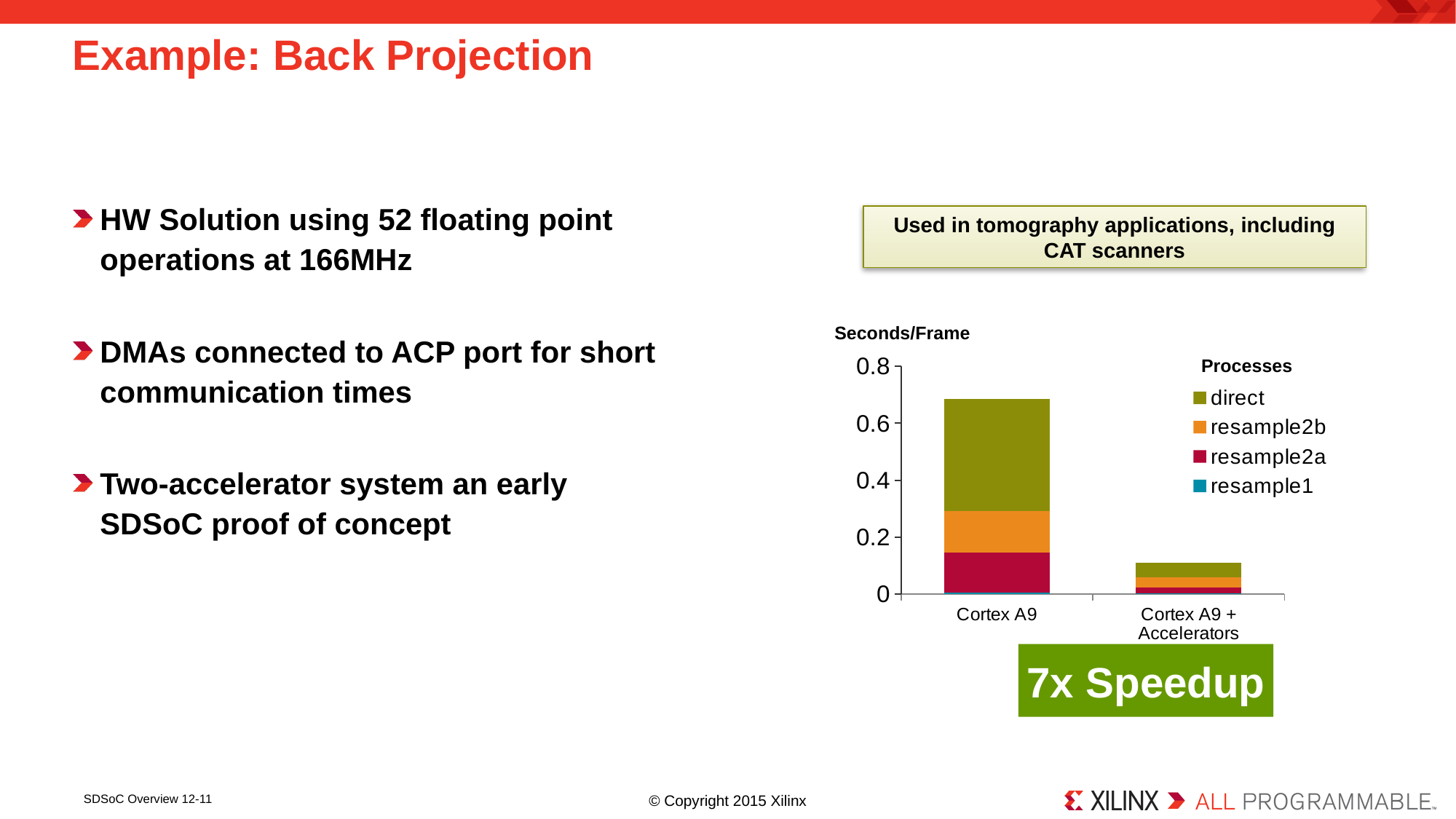
What kind of chart is shown on the slide? stacked bar chart Is the total bar for Cortex A9 + Accelerators greater or less than 0.2? less Is the total bar for Cortex A9 greater or less than 0.8? less Which is larger, the total bar for Cortex A9 or for Cortex A9 + Accelerators? Cortex A9 Is the total bar for Cortex A9 greater or less than 0.6? greater What is the label of the chart's vertical axis? Seconds/Frame How many categories are shown on the x axis of the chart? 2 Which category has the highest total bar in the chart? Cortex A9 How many series does the chart's legend list? 4 What is the title of the chart's legend? Processes Which series takes up the largest portion of the Cortex A9 bar? direct Which category has the lowest total bar in the chart? Cortex A9 + Accelerators